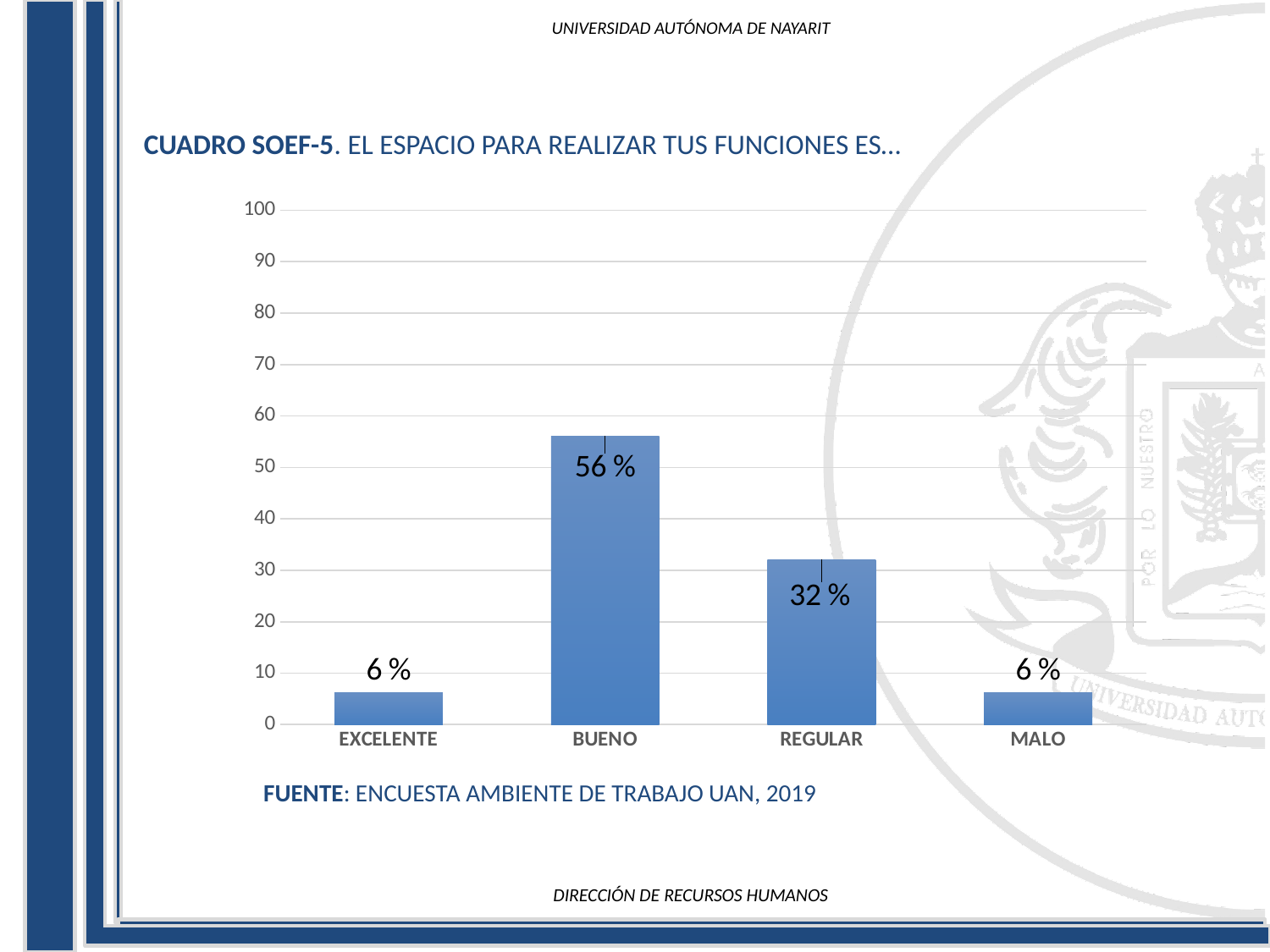
Which is larger, the value for REGULAR or the value for MALO? REGULAR What is the source cited below the chart? ENCUESTA AMBIENTE DE TRABAJO UAN, 2019 What is the title of the chart? CUADRO SOEF-5. EL ESPACIO PARA REALIZAR TUS FUNCIONES ES… Is the value for BUENO greater or less than 50? greater What is the value for BUENO? 56 % Which category has the highest value? BUENO What is the difference between the values for BUENO and REGULAR? 24 % What is the value for EXCELENTE? 6 % Is the value for MALO greater or less than 10? less How many categories are shown on the x axis? 4 What is the value for REGULAR? 32 % What kind of chart is shown on the slide? bar chart